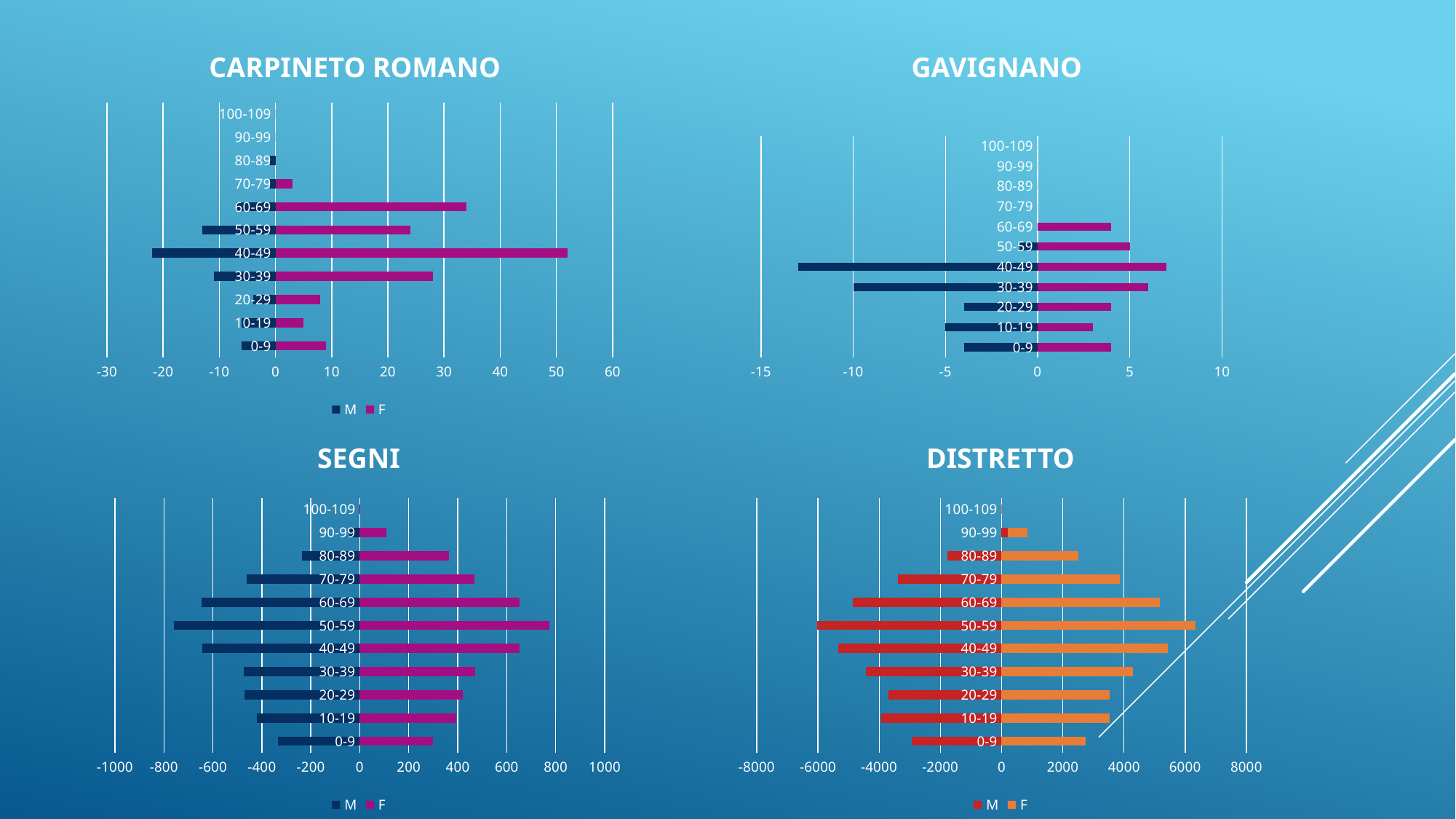
In the CARPINETO ROMANO chart, is the F value for 60-69 greater or less than 30? greater What are the two legend entries on the DISTRETTO chart? M and F What kind of chart is the CARPINETO ROMANO chart? bar chart In the GAVIGNANO chart, is the F value for 40-49 greater or less than 5? greater In the GAVIGNANO chart, which age group has the longest M bar? 40-49 In the SEGNI chart, which F bar is longer, 90-99 or 80-89? 80-89 In the SEGNI chart, is the F value for 50-59 greater or less than 600? greater In the DISTRETTO chart, which age group has the longest F bar? 50-59 In the SEGNI chart, which age group has the longest F bar? 50-59 How many series does the legend of the SEGNI chart list? 2 How many age-group categories are shown on the DISTRETTO chart? 11